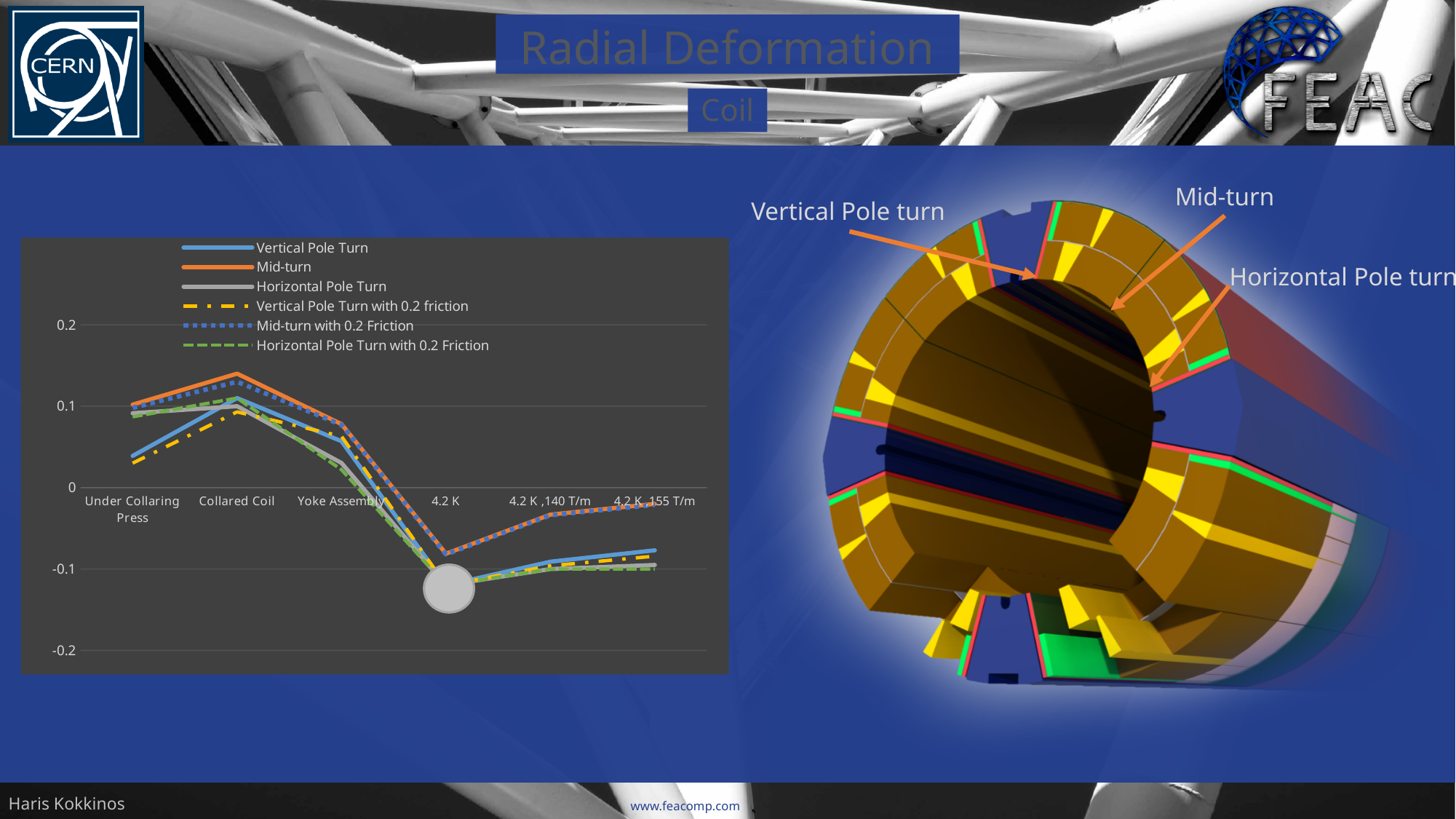
Is the value for Vertical Pole Turn at Under Collaring Press greater or less than 0.1? less Which category has the lowest value for the Mid-turn series? 4.2 K How many series does the chart legend list? 6 At Collared Coil, which is larger: Mid-turn or Horizontal Pole Turn? Mid-turn Does the Mid-turn series rise or fall from Yoke Assembly to 4.2 K? fall What kind of chart is shown on the slide? line chart Is the value for Mid-turn at 4.2 K ,155 T/m greater or less than 0? less How many categories are shown along the x axis of the chart? 6 What colour is the Mid-turn line in the chart legend? orange Is the value for Horizontal Pole Turn at 4.2 K greater or less than -0.1? less Which category has the highest value for the Mid-turn series? Collared Coil